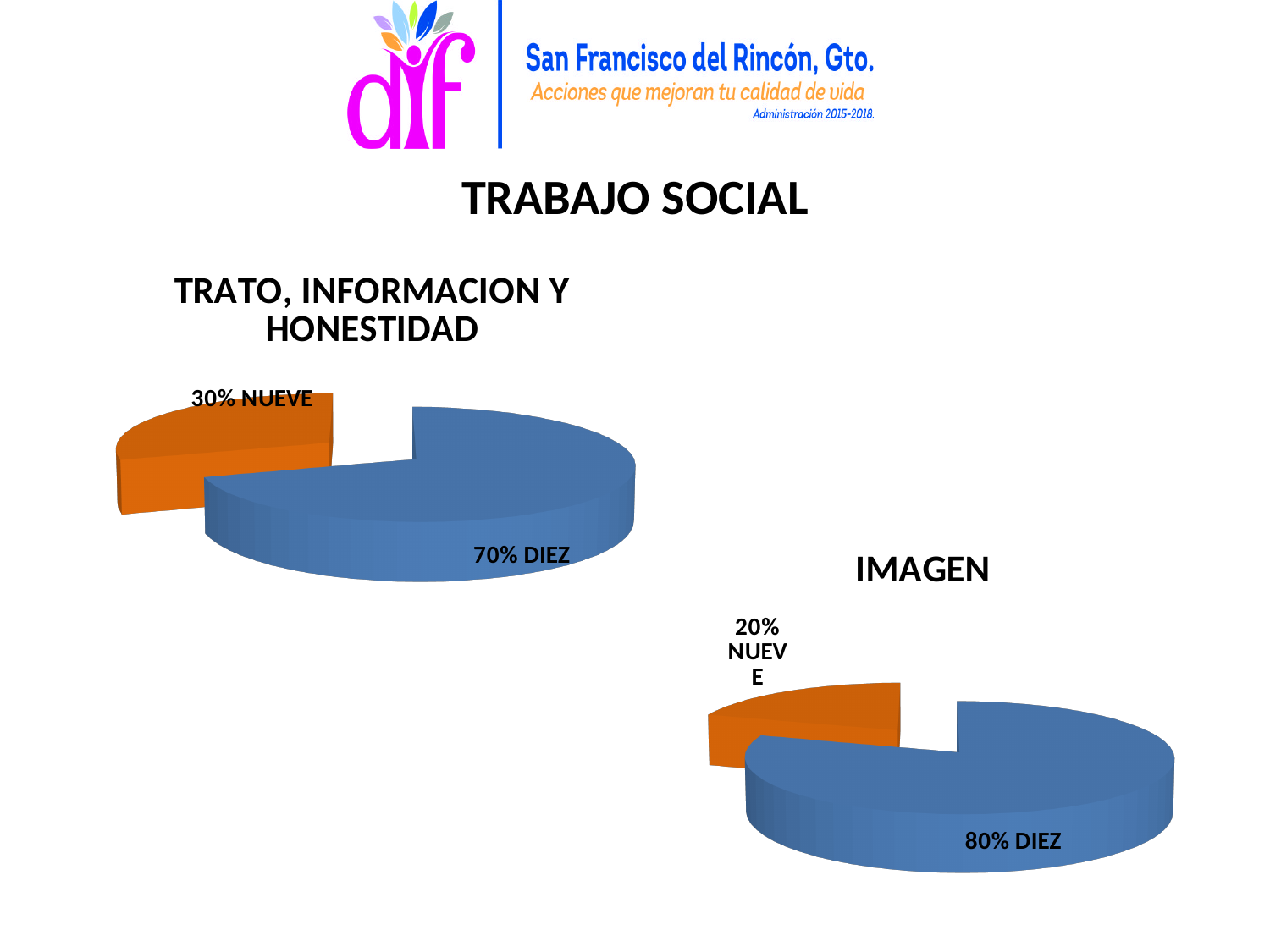
In the 'TRATO, INFORMACION Y HONESTIDAD' chart, which slice is the largest? DIEZ How many slices does the 'TRATO, INFORMACION Y HONESTIDAD' chart have? 2 In the 'IMAGEN' chart, which slice is the smallest? NUEVE In the 'IMAGEN' chart, what share does the DIEZ slice have? 80% In the 'TRATO, INFORMACION Y HONESTIDAD' chart, what share does the DIEZ slice have? 70% In the 'TRATO, INFORMACION Y HONESTIDAD' chart, what share does the NUEVE slice have? 30% In the 'IMAGEN' chart, what colour is the DIEZ slice? Blue What type of chart is the 'IMAGEN' chart? Pie chart In the 'TRATO, INFORMACION Y HONESTIDAD' chart, what is the difference in percentage points between the DIEZ and NUEVE slices? 40 In the 'IMAGEN' chart, what is the difference in percentage points between the DIEZ and NUEVE slices? 60 In the 'IMAGEN' chart, which slice is larger, DIEZ or NUEVE? DIEZ